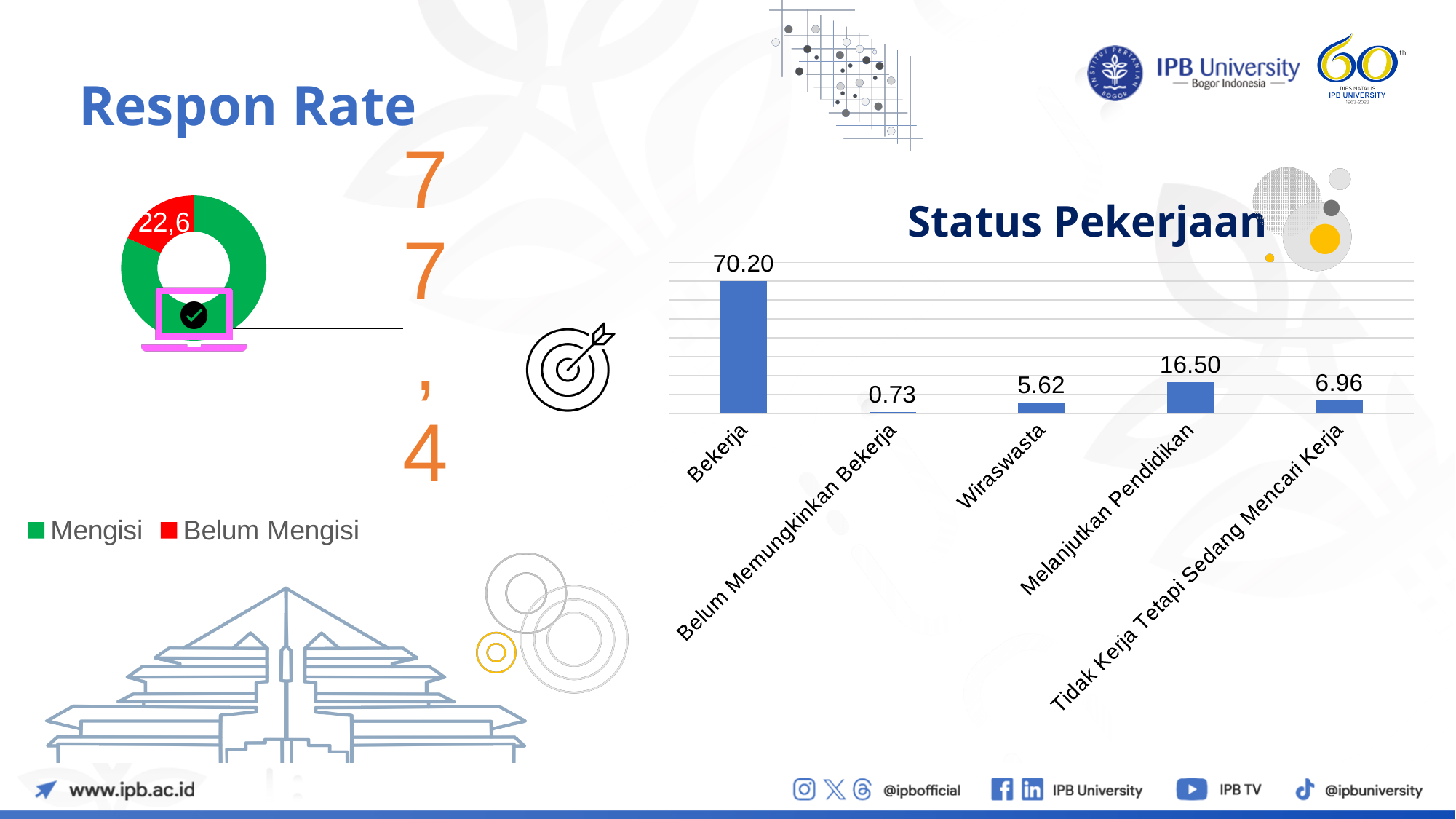
In the Status Pekerjaan chart, what is the value for Belum Memungkinkan Bekerja? 0.73 In the Respon Rate chart, which segment is larger: Mengisi or Belum Mengisi? Mengisi How many categories are shown in the Status Pekerjaan chart? 5 What kind of chart is the Status Pekerjaan chart? Bar chart In the Status Pekerjaan chart, what is the value for Melanjutkan Pendidikan? 16.50 How many entries does the legend of the Respon Rate chart list? 2 In the Status Pekerjaan chart, which category has the highest value? Bekerja In the Status Pekerjaan chart, which category has the lowest value? Belum Memungkinkan Bekerja In the Status Pekerjaan chart, what is the difference between the values for Melanjutkan Pendidikan and Wiraswasta? 10.88 In the Status Pekerjaan chart, which is larger: Tidak Kerja Tetapi Sedang Mencari Kerja or Wiraswasta? Tidak Kerja Tetapi Sedang Mencari Kerja In the Status Pekerjaan chart, what is the value for Bekerja? 70.20 In the Respon Rate chart, what is the value for Belum Mengisi? 22,6